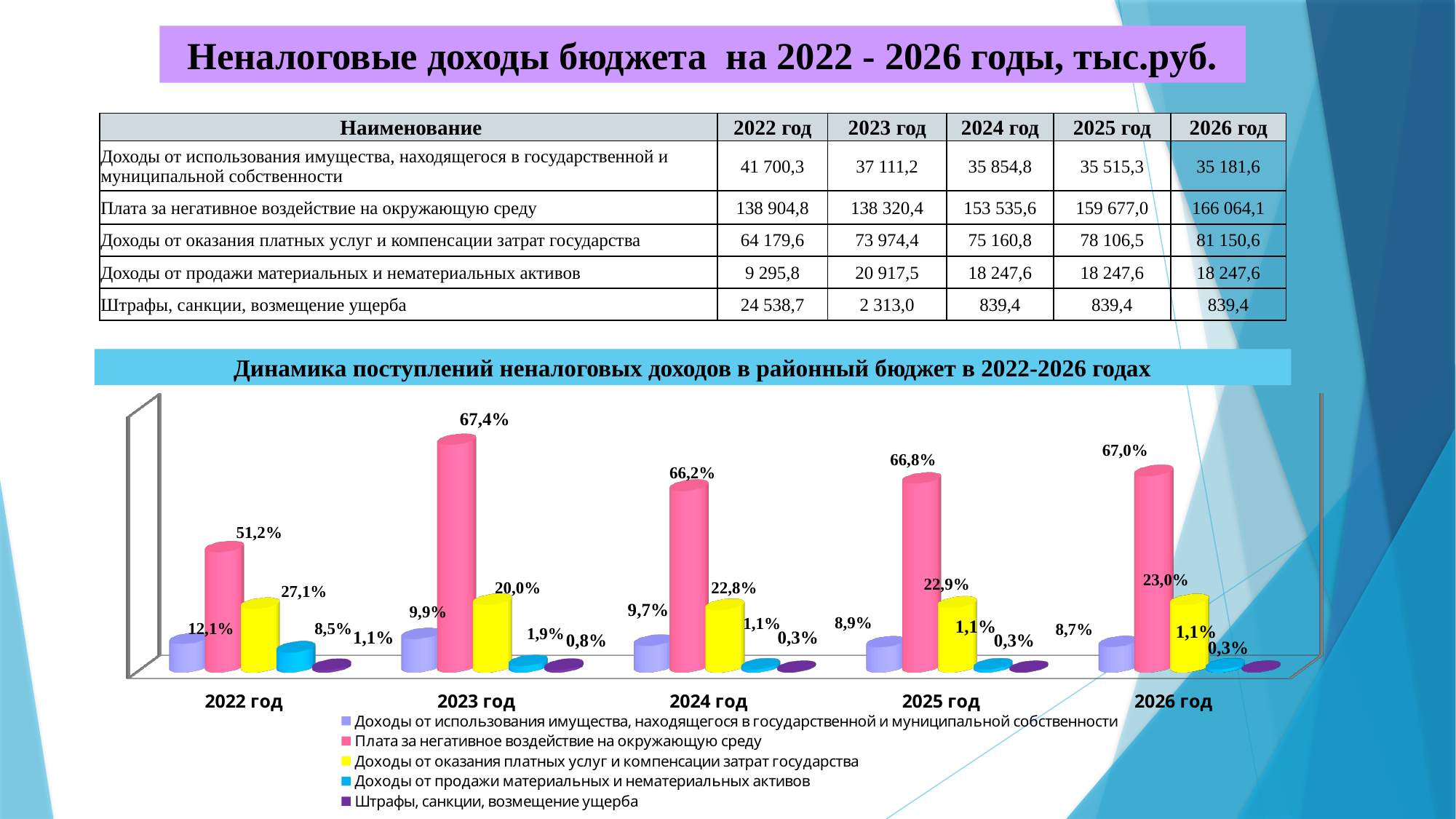
Which is larger: the 'Доходы от оказания платных услуг и компенсации затрат государства' value in 2022 год or in 2023 год? 2022 год What is the value for 'Доходы от оказания платных услуг и компенсации затрат государства' in 2022 год? 27,1% Does the value for 'Доходы от использования имущества, находящегося в государственной и муниципальной собственности' rise or fall from 2022 год to 2026 год? fall In which year is the value for 'Плата за негативное воздействие на окружающую среду' the lowest? 2022 год How many series does the chart legend list? 5 What is the value for 'Штрафы, санкции, возмещение ущерба' in 2023 год? 0,8% What is the value for 'Плата за негативное воздействие на окружающую среду' in 2023 год? 67,4% What is the difference between the 'Плата за негативное воздействие на окружающую среду' values in 2023 год and 2022 год? 16,2% In which year is the value for 'Доходы от продажи материальных и нематериальных активов' the highest? 2022 год How many year categories are shown on the x axis of the chart? 5 What is the value for 'Доходы от использования имущества, находящегося в государственной и муниципальной собственности' in 2026 год? 8,7% What kind of chart is shown on the slide? bar chart